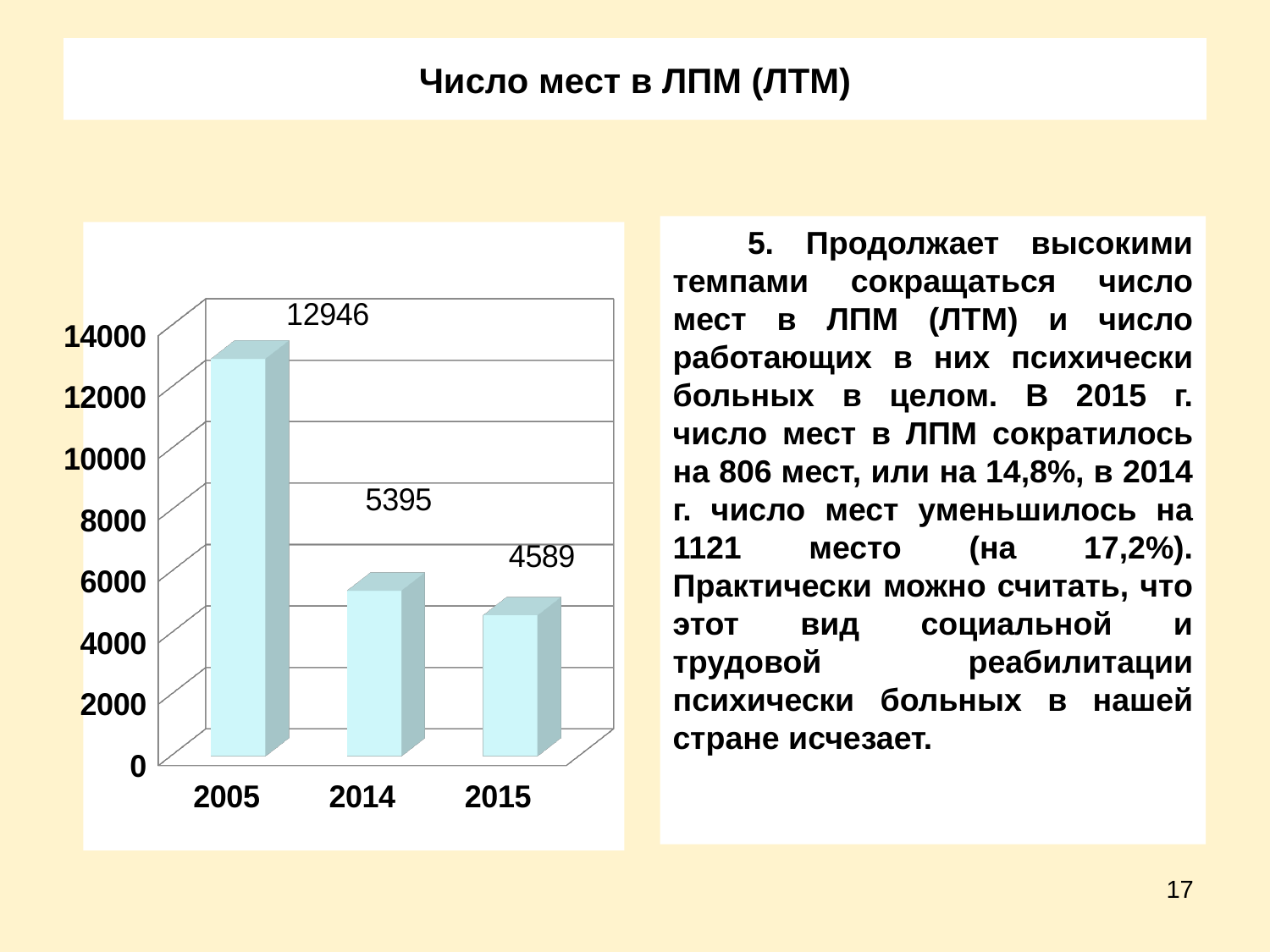
What is the value for 2005? 12946 What is the value for 2015? 4589 Is the value for 2005 greater or less than 12000? greater What is the difference between the values for 2014 and 2015? 806 What is the difference between the values for 2005 and 2014? 7551 Which is larger, the value for 2014 or the value for 2015? 2014 What is the value for 2014? 5395 What kind of chart is shown? bar chart How many years are shown on the x axis? 3 Which year has the lowest value? 2015 Which year has the highest value? 2005 Do the values rise or fall from 2005 to 2015? fall